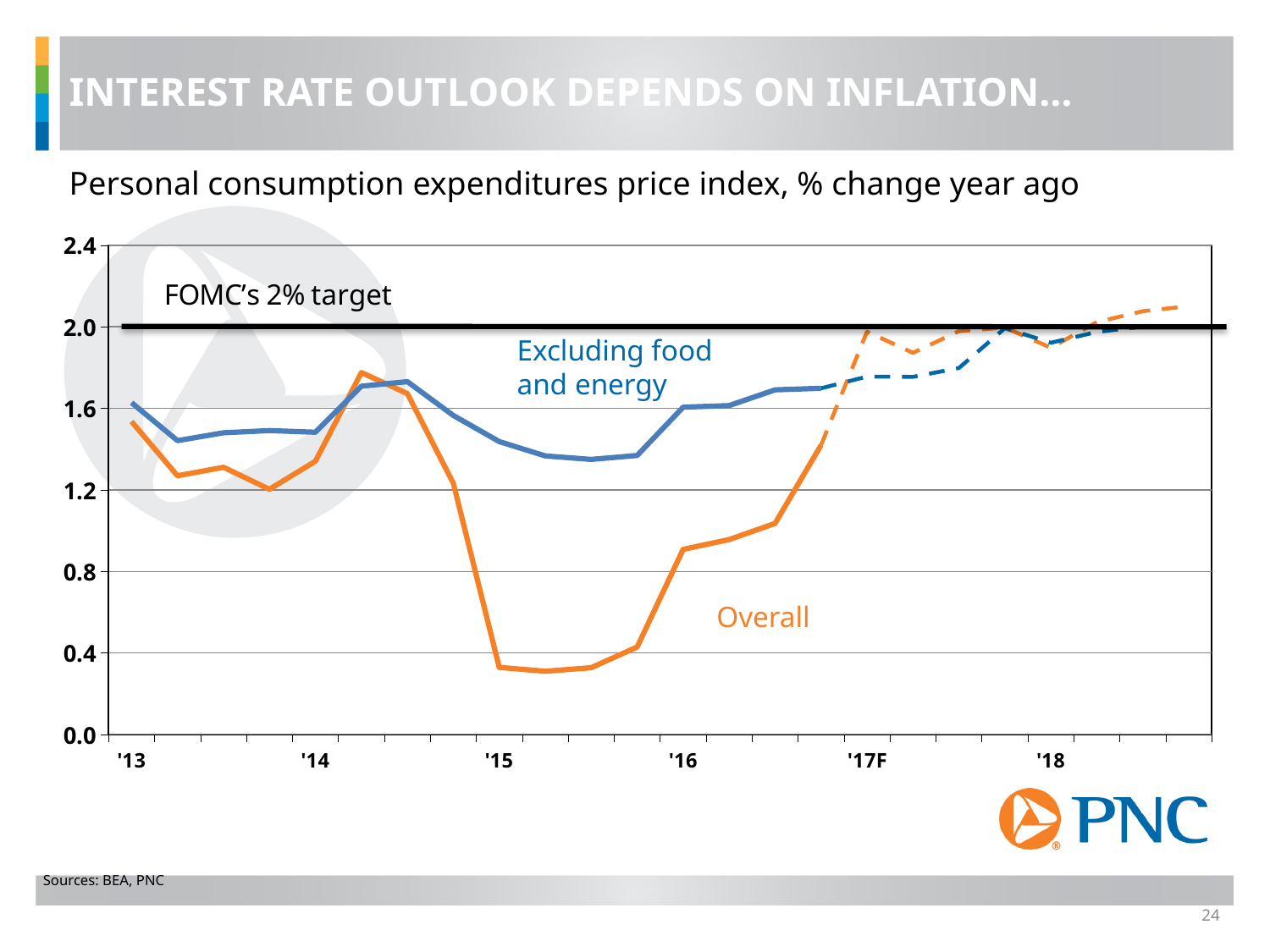
Is the value of the Excluding food and energy series at '15 greater or less than 1.2? greater Is the value of the Overall series at '13 greater or less than 1.6? less Does the Overall series rise or fall between '14 and '15? fall At '15, which series has the higher value, Overall or Excluding food and energy? Excluding food and energy Is the value of the Overall series at '15 greater or less than 0.4? less At '17F, which series has the higher value, Overall or Excluding food and energy? Overall What kind of chart is shown on the slide? line chart What is the title of the chart? Personal consumption expenditures price index, % change year ago Does the Excluding food and energy series rise or fall between '16 and '18? rise At what level is the horizontal FOMC target line drawn? 2.0 How many data series are plotted on the chart (excluding the target line)? 2